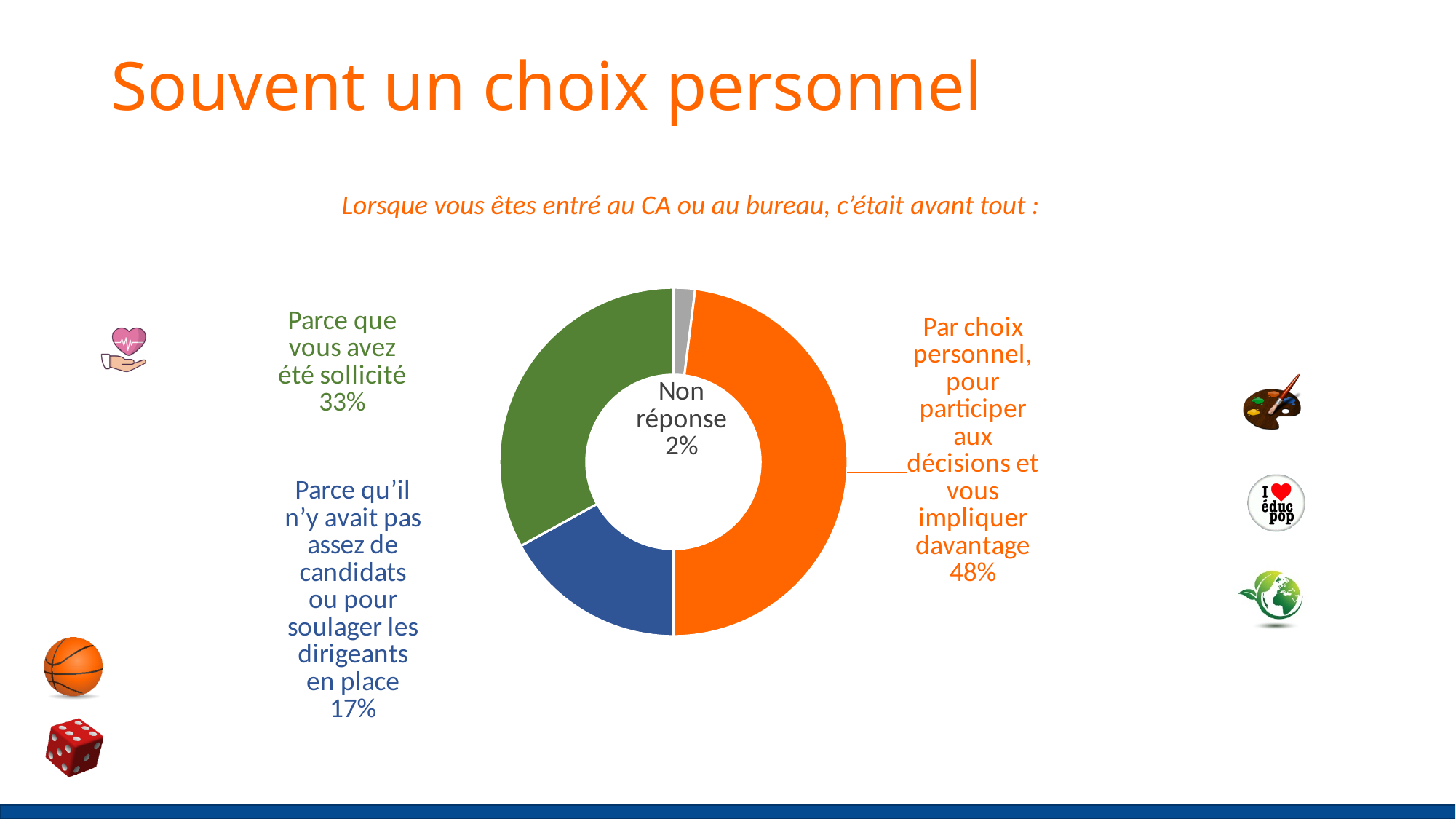
Which slice of the pie is the largest? Par choix personnel, pour participer aux décisions et vous impliquer davantage What share of the pie is labelled "Par choix personnel, pour participer aux décisions et vous impliquer davantage"? 48% Which slice of the pie is the smallest? Non réponse What share of the pie is labelled "Parce que vous avez été sollicité"? 33% What share of the pie is labelled "Parce qu'il n'y avait pas assez de candidats ou pour soulager les dirigeants en place"? 17% How many slices does the pie chart have? 4 What is the difference in percentage points between the "Parce que vous avez été sollicité" slice and the "Parce qu'il n'y avait pas assez de candidats" slice? 16 Which is larger: the "Parce que vous avez été sollicité" slice or the "Parce qu'il n'y avait pas assez de candidats" slice? Parce que vous avez été sollicité What kind of chart is shown on the slide? Pie chart (doughnut) What is the difference in percentage points between the "Par choix personnel" slice and the "Parce que vous avez été sollicité" slice? 15 What colour is the slice for "Parce que vous avez été sollicité"? Green